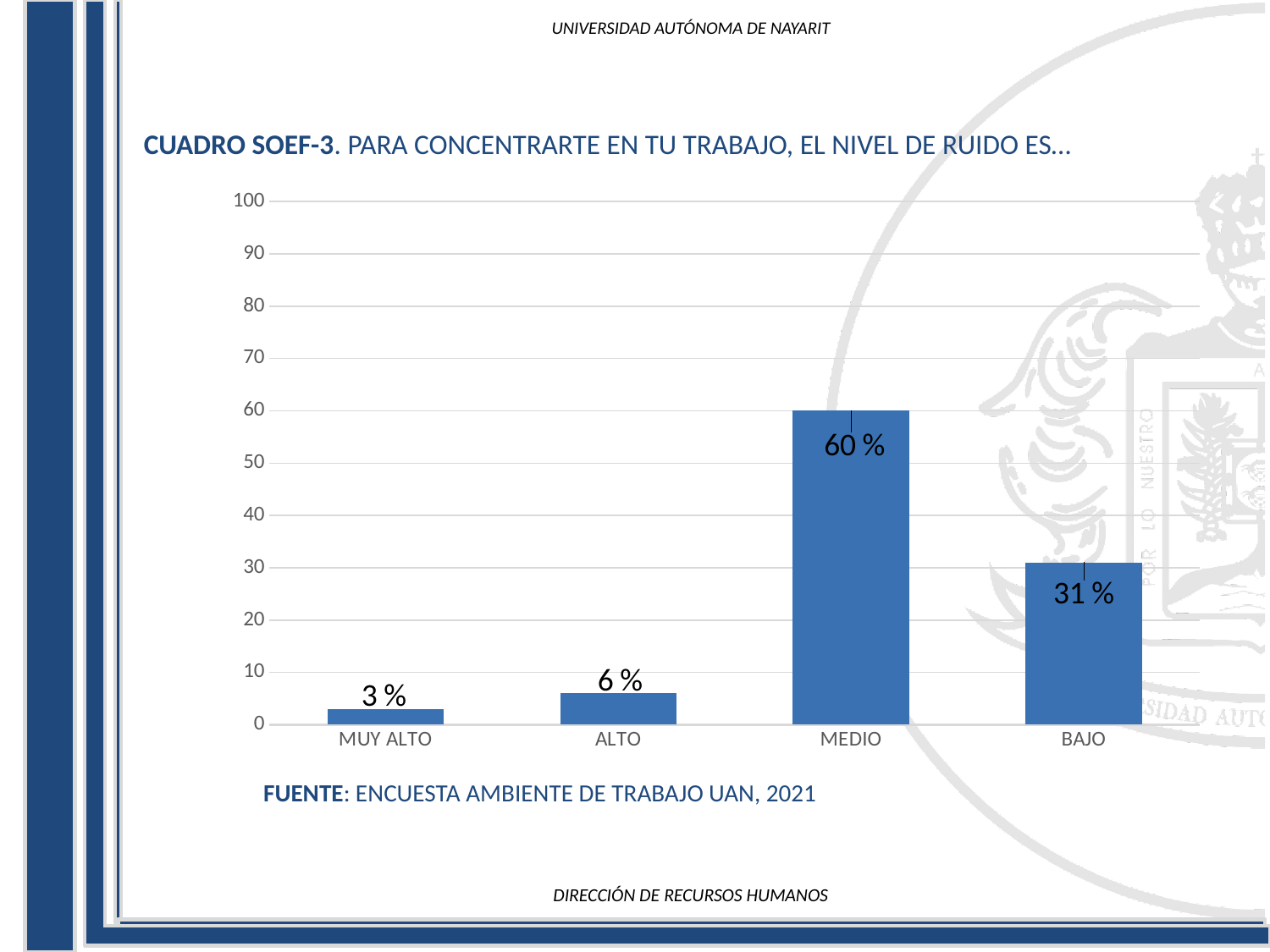
Is the value for BAJO greater or less than 40? less Which category has the highest value? MEDIO What is the value for BAJO? 31 % What is the difference between the values for MEDIO and BAJO? 29 % How many categories are shown on the x axis? 4 What is the value for MUY ALTO? 3 % Which category has the lowest value? MUY ALTO What source is cited below the chart? ENCUESTA AMBIENTE DE TRABAJO UAN, 2021 What is the value for MEDIO? 60 % What kind of chart is shown on the slide? bar chart What is the value for ALTO? 6 % Which is larger, the value for ALTO or the value for MUY ALTO? ALTO